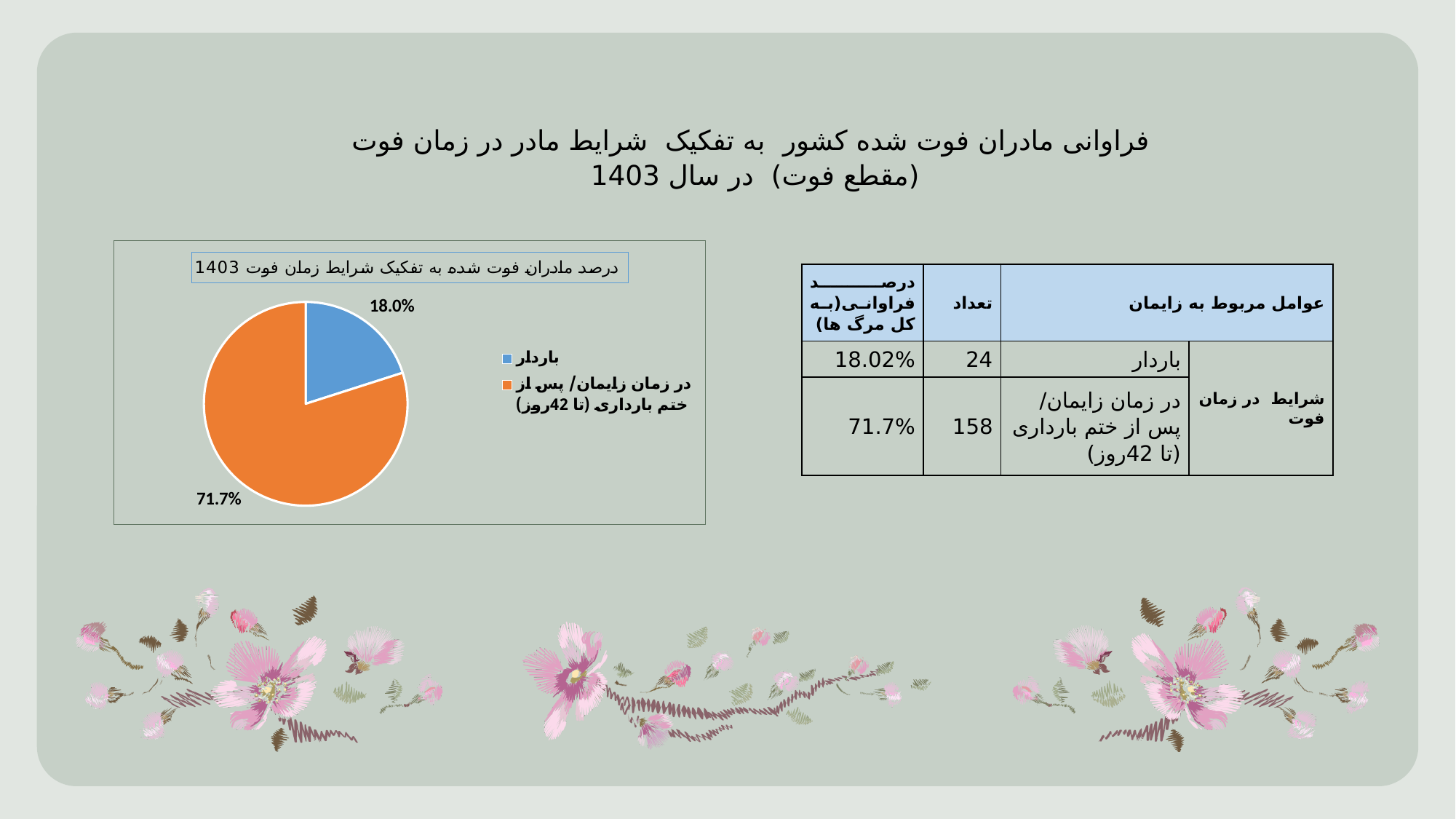
What kind of chart is shown on the slide? pie chart What is the title of the pie chart? درصد مادران فوت شده به تفکیک شرایط زمان فوت 1403 What colour is the slice for باردار in the pie chart? blue How many slices does the pie chart have? 2 Which category has the largest slice in the pie chart? در زمان زایمان/ پس از ختم بارداری (تا 42 روز) Which category has the smallest slice in the pie chart? باردار What share of the pie does the باردار slice represent? 18.0% How many entries does the legend of the pie chart list? 2 What percentage does the pie chart show for the category در زمان زایمان/ پس از ختم بارداری (تا 42 روز)? 71.7% What is the difference in percentage points between the slice for در زمان زایمان/ پس از ختم بارداری (تا 42 روز) and the slice for باردار? 53.7 Which slice is larger in the pie chart: باردار or در زمان زایمان/ پس از ختم بارداری (تا 42 روز)? در زمان زایمان/ پس از ختم بارداری (تا 42 روز) What percentage does the pie chart show for the category باردار? 18.0%